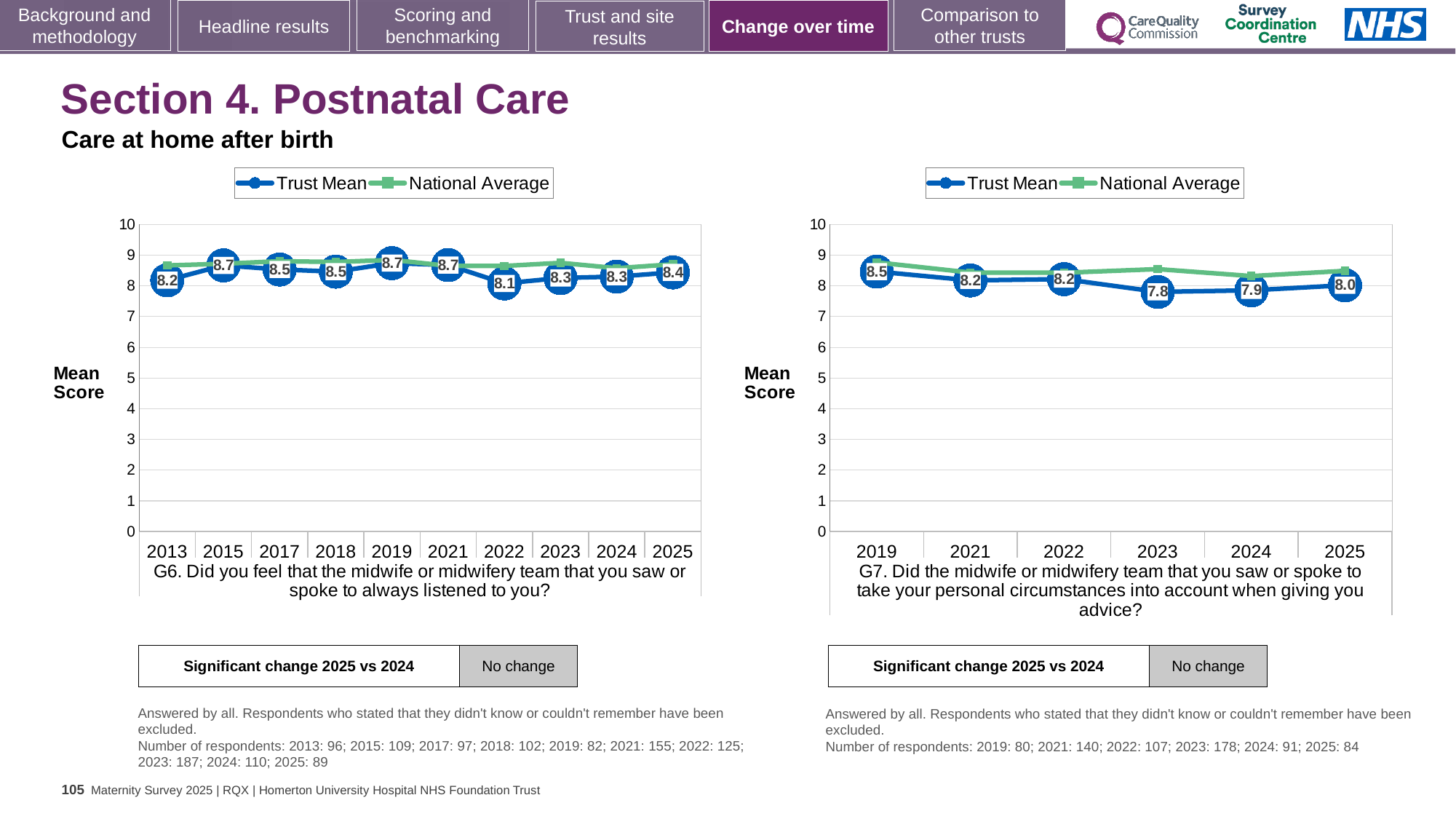
In the G6 chart on the left, what is the Trust Mean score for 2013? 8.2 In the G6 chart on the left, which year has the lowest Trust Mean score? 2022 In the G7 chart on the right, is the National Average value for 2025 greater or less than 8? greater In the G6 chart on the left, how many years are shown on the x axis? 10 In the G7 chart on the right, which year has the highest Trust Mean score? 2019 In the G7 chart on the right, which year has the lowest Trust Mean score? 2023 In the G7 chart on the right, what is the Trust Mean score for 2023? 7.8 In the G7 chart on the right, is the Trust Mean score for 2019 larger or smaller than the score for 2025? larger In the G6 chart on the left, what is the Trust Mean score for 2025? 8.4 How many series does the legend of the G7 chart on the right list? 2 In the G6 chart on the left, what is the difference between the Trust Mean scores for 2015 and 2022? 0.6 What kind of chart is the G6 chart on the left? Line chart